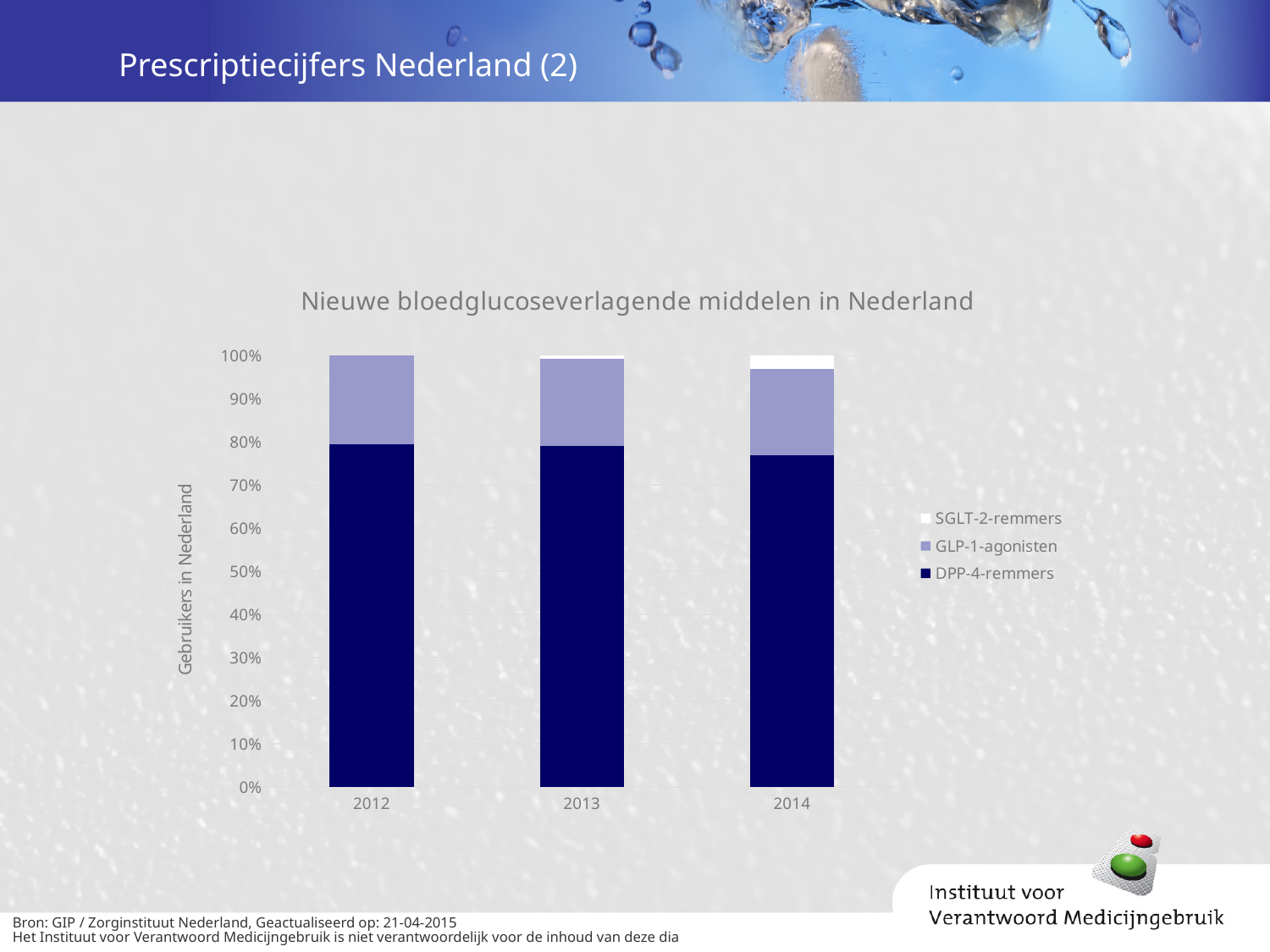
Is the share of GLP-1-agonisten in 2013 greater or less than 30%? less What is the title of the chart? Nieuwe bloedglucoseverlagende middelen in Nederland How many series does the chart legend list? 3 Is the share of DPP-4-remmers in 2014 greater or less than 80%? less How many years are shown on the x axis of the chart? 3 What is the label on the vertical axis of the chart? Gebruikers in Nederland What kind of chart is shown on the slide? stacked bar chart Is the share of DPP-4-remmers in 2012 greater or less than 70%? greater Which year has the larger share of DPP-4-remmers, 2012 or 2014? 2012 In which year is the share of DPP-4-remmers the lowest? 2014 Does the share of DPP-4-remmers rise or fall from 2012 to 2014? fall